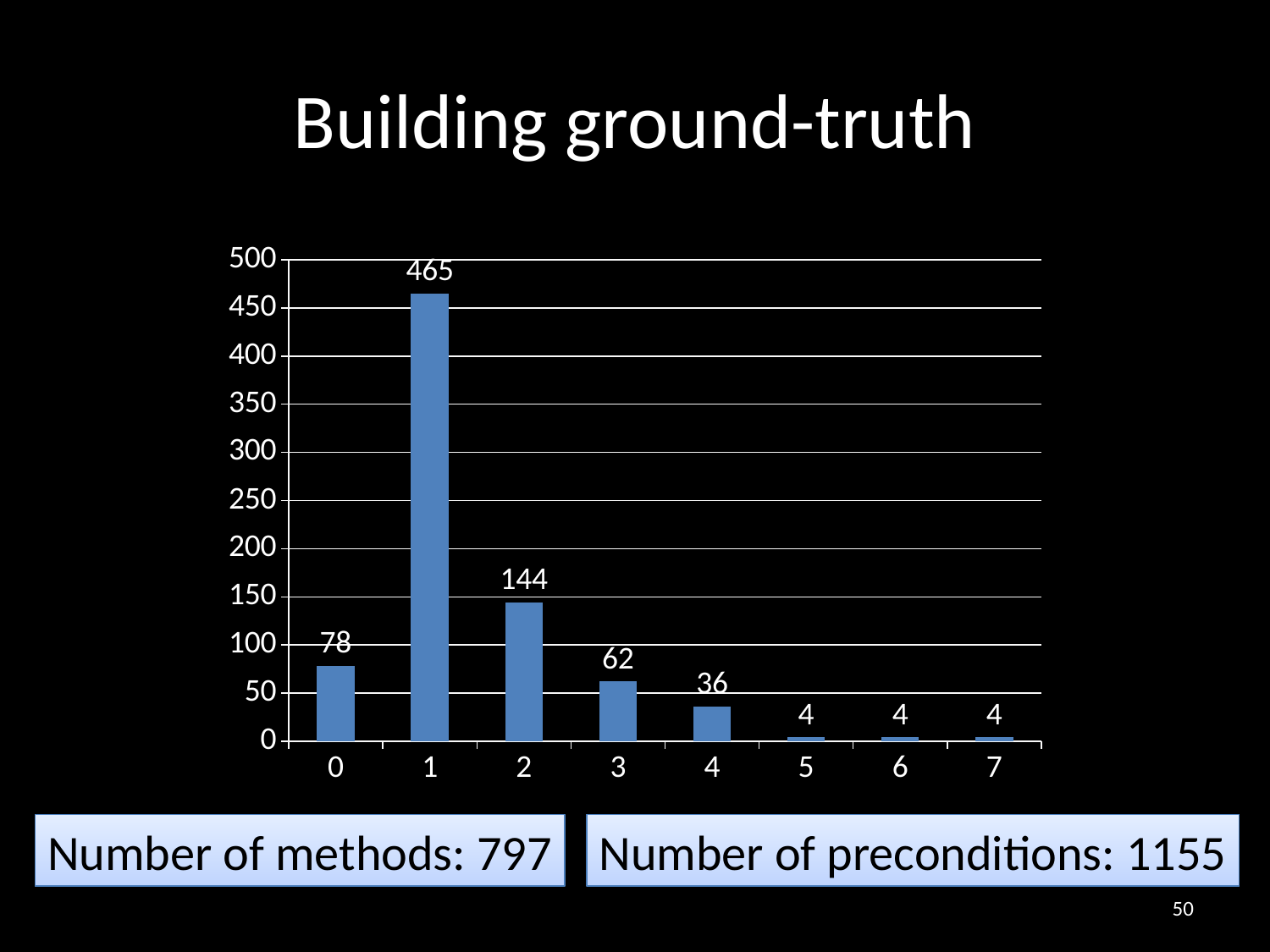
What is the title of the slide containing the chart? Building ground-truth Which category has the highest value? 1 What is the difference between the values for category 1 and category 2? 321 What is the value for category 4? 36 What is the value for category 0? 78 What is the value for category 2? 144 Is the value for category 2 greater or less than 100? greater How many categories are shown on the x axis? 8 What is the value for category 1? 465 Which is larger, the value for category 0 or the value for category 3? category 0 What kind of chart is shown on the slide? bar chart What is the difference between the values for category 0 and category 3? 16